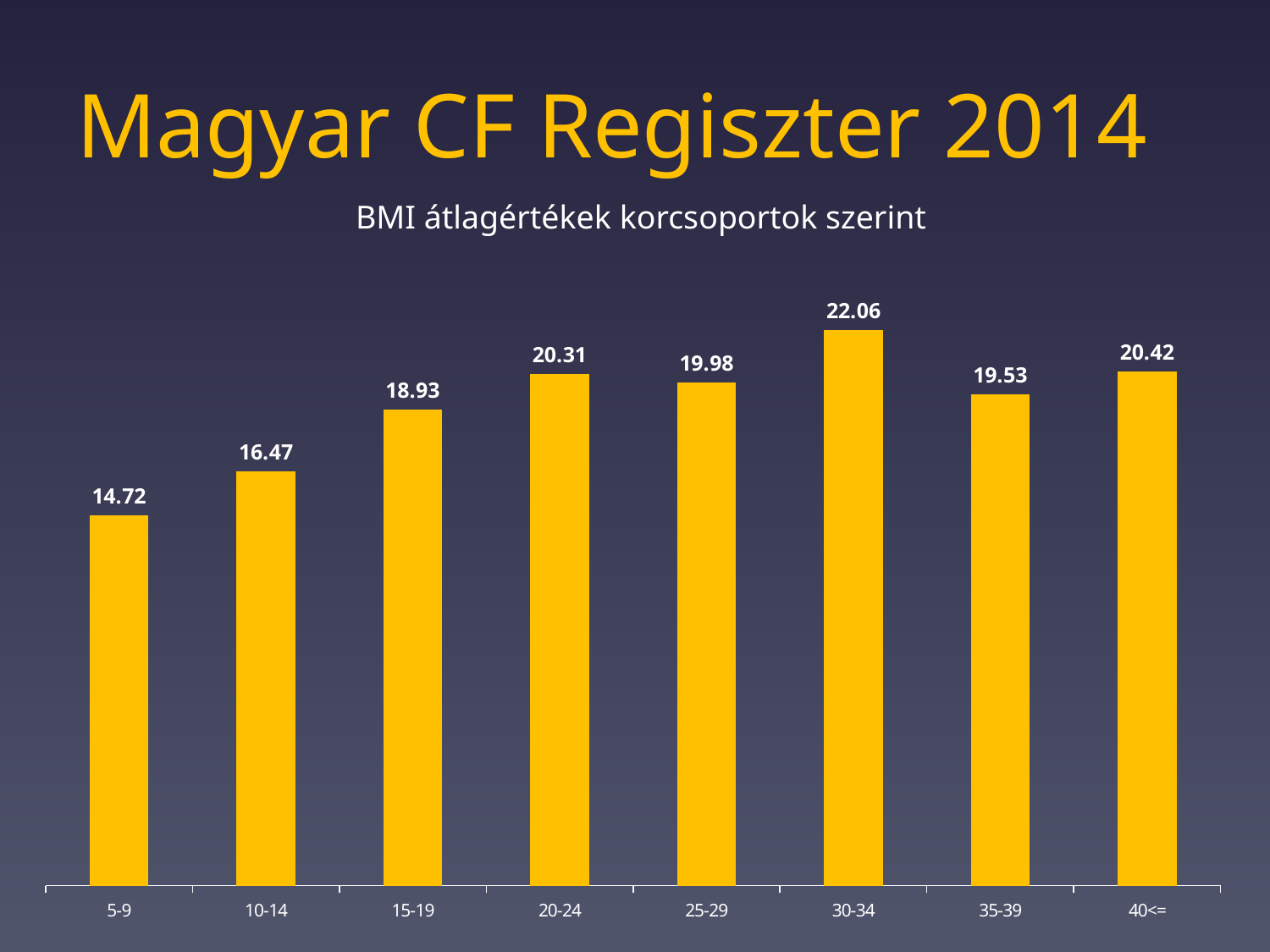
How many age groups are shown in the chart? 8 What kind of chart is shown on the slide? Bar chart Which age group has the highest average BMI? 30-34 What is the average BMI value for the 30-34 age group? 22.06 What is the subtitle of the chart? BMI átlagértékek korcsoportok szerint What is the difference between the average BMI of the 30-34 group and the 5-9 group? 7.34 What is the average BMI value for the 40<= age group? 20.42 Does the average BMI rise or fall from the 5-9 group to the 30-34 group? Rise Which age group has the lowest average BMI? 5-9 What is the average BMI value for the 5-9 age group? 14.72 Which age group has a higher average BMI, 25-29 or 35-39? 25-29 What is the difference between the average BMI of the 20-24 group and the 15-19 group? 1.38